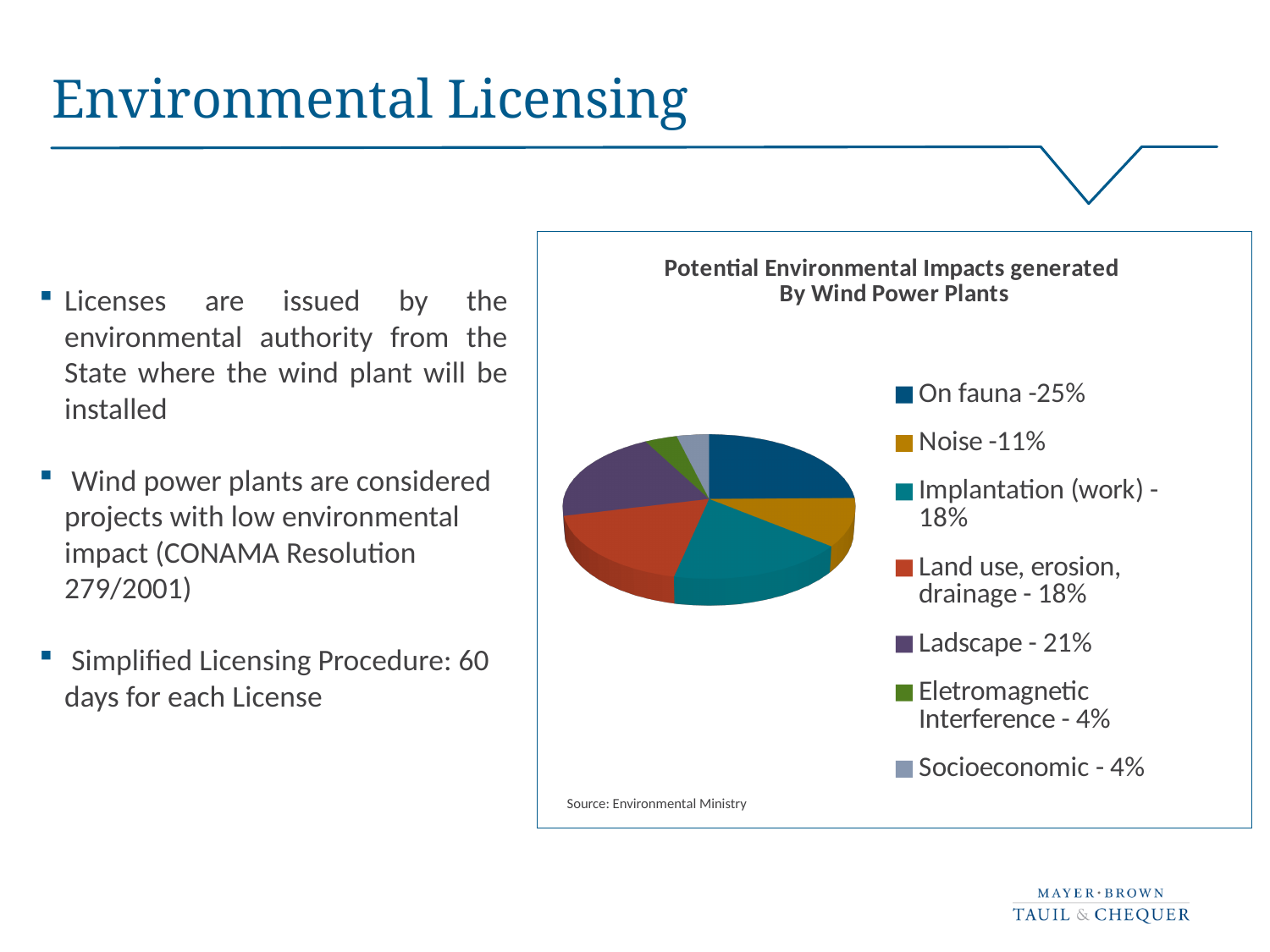
Which category has the largest share of the pie? On fauna What type of chart is shown on the slide? Pie chart What is the title of the chart? Potential Environmental Impacts generated By Wind Power Plants What source is cited for the chart? Environmental Ministry What is the difference in percentage points between 'On fauna' and 'Noise'? 14 What percentage is shown for 'Ladscape'? 21% How many categories does the pie chart show? 7 What percentage is shown for 'Noise'? 11% What percentage is shown for 'Socioeconomic'? 4% What is the difference in percentage points between 'Ladscape' and 'Implantation (work)'? 3 Which is larger, the share for 'Ladscape' or the share for 'Noise'? Ladscape What share of the pie is attributed to 'On fauna'? 25%